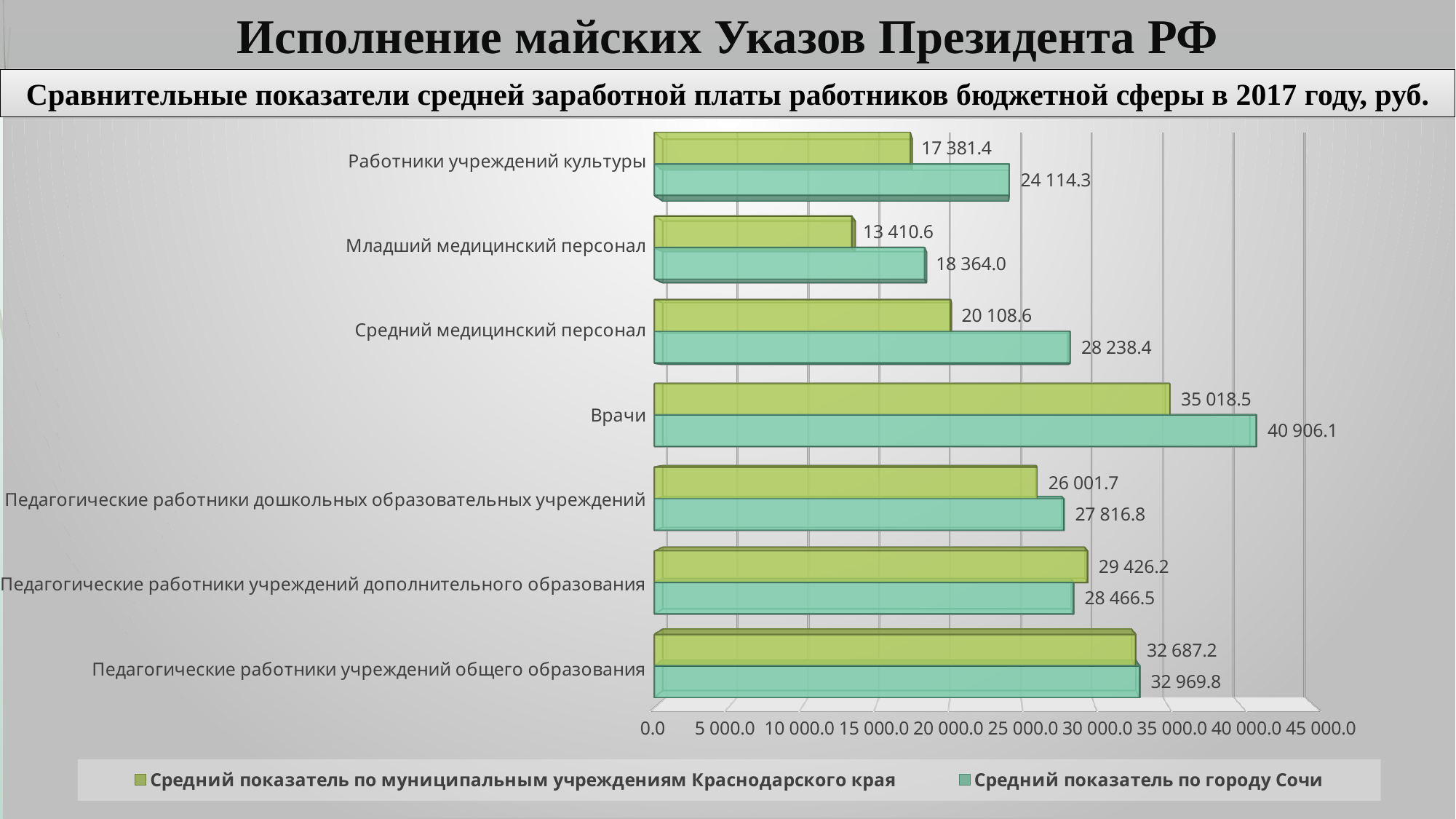
How many categories are shown on the chart? 7 What is the subtitle of the chart on the slide? Сравнительные показатели средней заработной платы работников бюджетной сферы в 2017 году, руб. What is the value for Врачи in the series Средний показатель по городу Сочи? 40 906.1 Which category has the lowest value in the series Средний показатель по муниципальным учреждениям Краснодарского края? Младший медицинский персонал What type of chart is shown on the slide? Bar chart For Педагогические работники учреждений дополнительного образования, which series has the larger value? Средний показатель по муниципальным учреждениям Краснодарского края What is the value for Работники учреждений культуры in the series Средний показатель по городу Сочи? 24 114.3 Which category has the highest value in the series Средний показатель по городу Сочи? Врачи What is the value for Младший медицинский персонал in the series Средний показатель по муниципальным учреждениям Краснодарского края? 13 410.6 How many series does the legend list? 2 What is the difference between the Сочи value and the Краснодарский край value for Врачи? 5 887.6 Is the value for Средний медицинский персонал in the series Средний показатель по городу Сочи greater or less than 25 000.0? greater